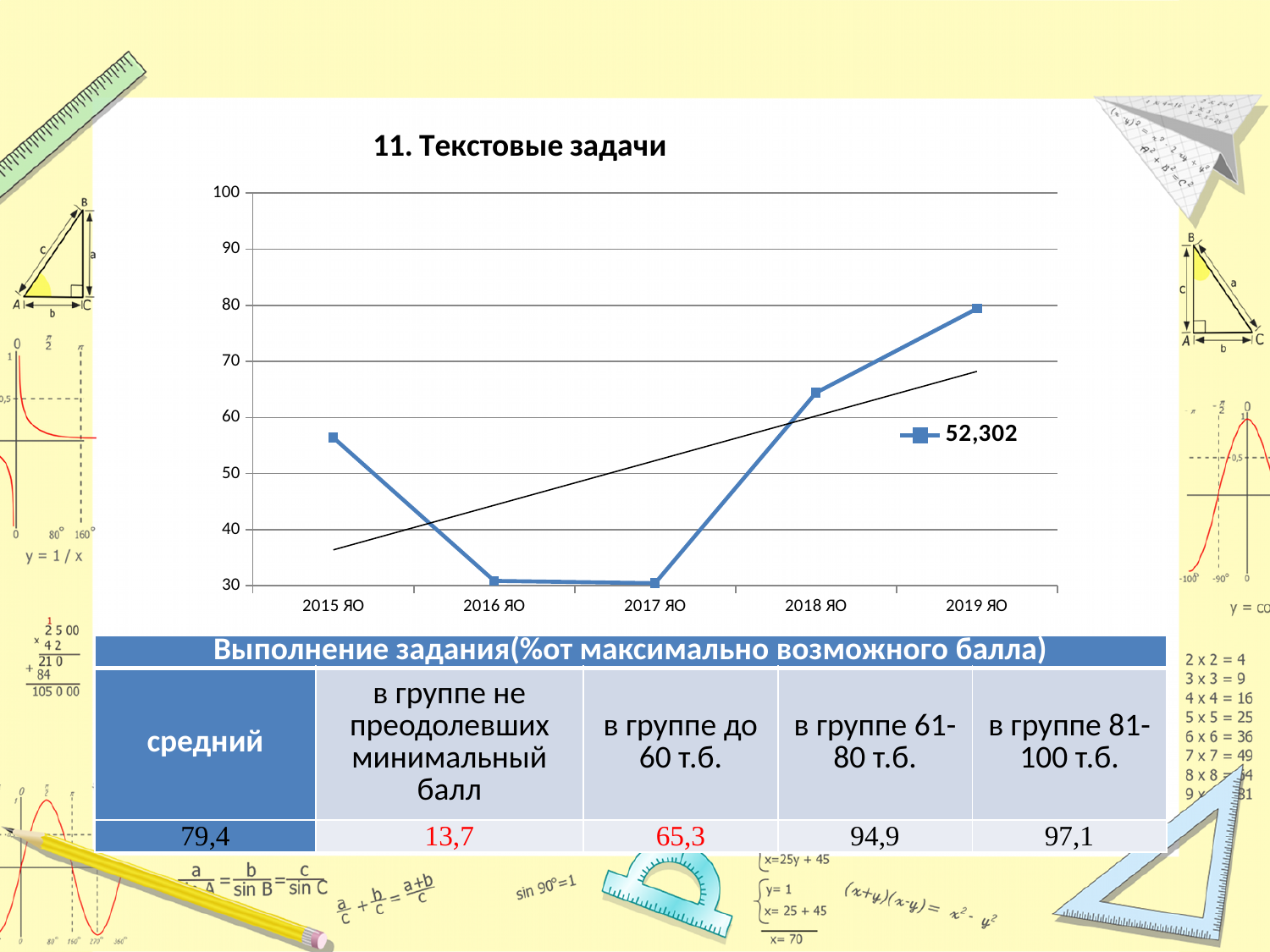
Is the value for 2018 ЯО greater or less than 60? greater Is the value for 2015 ЯО greater or less than 50? greater Is the value for 2019 ЯО greater or less than 70? greater Which year has the highest value on the chart? 2019 ЯО What is the title of the chart? 11. Текстовые задачи How many points are plotted along the x axis of the chart? 5 How many series does the chart legend list? 1 What kind of chart is shown on the slide? line chart Do the values rise or fall from 2017 ЯО to 2019 ЯО? rise Which is larger, the value for 2015 ЯО or the value for 2018 ЯО? 2018 ЯО What entry is shown in the chart legend? 52,302